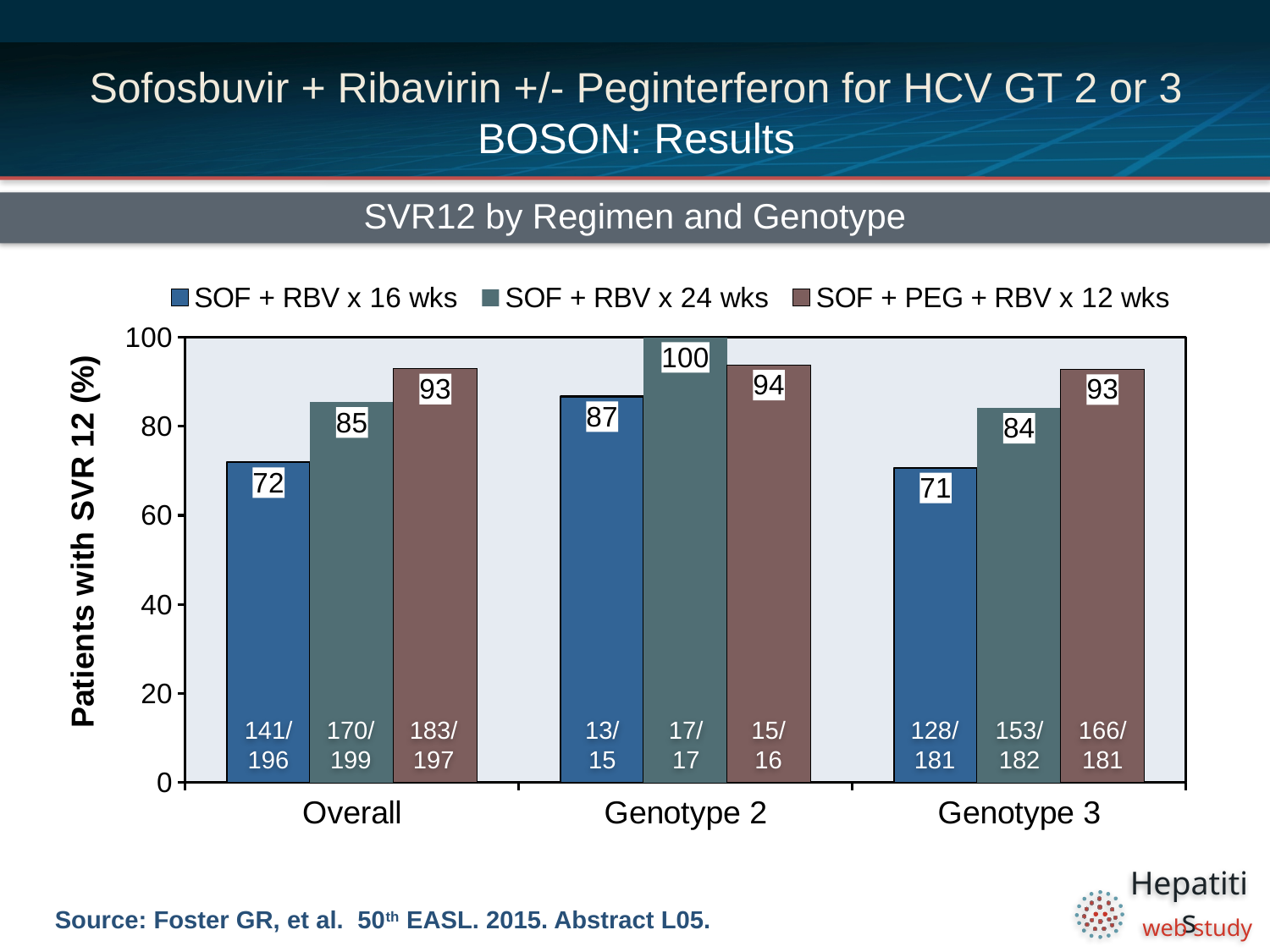
What is the label of the y axis? Patients with SVR 12 (%) What is the title of the chart? SVR12 by Regimen and Genotype Which is larger: the SVR12 rate for SOF + RBV x 24 wks in Genotype 2 or in Genotype 3? Genotype 2 Which regimen has the highest SVR12 rate in Genotype 3? SOF + PEG + RBV x 12 wks What is the difference in SVR12 rate between SOF + PEG + RBV x 12 wks and SOF + RBV x 16 wks in the Overall group? 21 What is the SVR12 rate for SOF + RBV x 16 wks in the Overall group? 72 What is the SVR12 rate for SOF + RBV x 24 wks in Genotype 2? 100 Which regimen has the lowest SVR12 rate in the Overall group? SOF + RBV x 16 wks How many series does the legend list? 3 How many genotype categories are shown on the x axis? 3 What kind of chart is shown on the slide? Bar chart What is the SVR12 rate for SOF + PEG + RBV x 12 wks in Genotype 3? 93